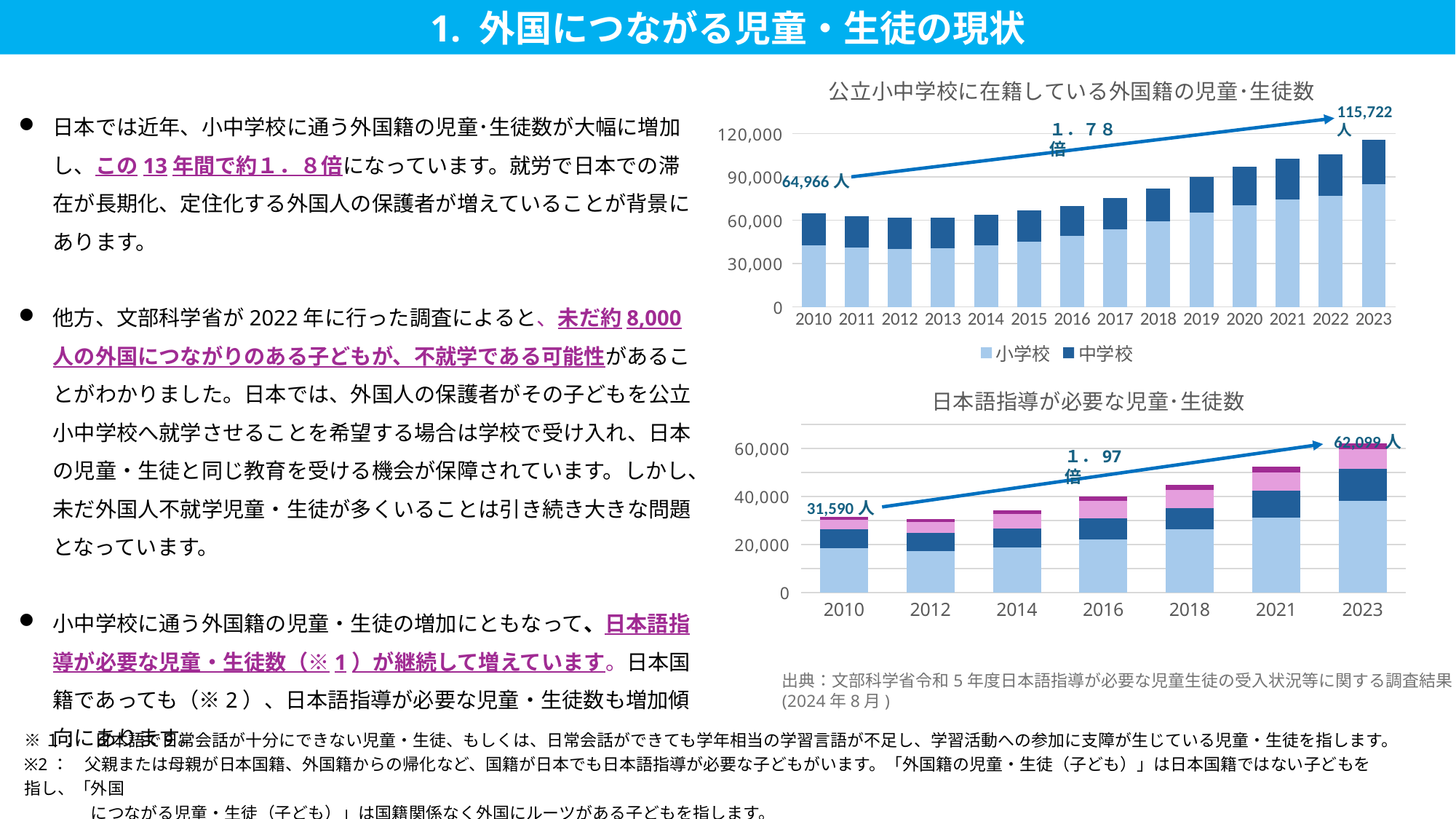
In the top chart (公立小中学校に在籍している外国籍の児童･生徒数), what is the difference between the 2023 total and the 2010 total? 50,756 人 What kind of chart is the top chart titled 公立小中学校に在籍している外国籍の児童･生徒数? bar chart In the bottom chart (日本語指導が必要な児童･生徒数), do the totals rise or fall from 2010 to 2023? rise In the top chart (公立小中学校に在籍している外国籍の児童･生徒数), what is the labelled total for 2023? 115,722 人 In the top chart (公立小中学校に在籍している外国籍の児童･生徒数), what is the labelled total for 2010? 64,966 人 In the top chart (公立小中学校に在籍している外国籍の児童･生徒数), how many years are shown on the x axis? 14 In the top chart (公立小中学校に在籍している外国籍の児童･生徒数), is the total for 2018 greater or less than 90,000? less What are the two legend entries of the top chart (公立小中学校に在籍している外国籍の児童･生徒数)? 小学校, 中学校 In the bottom chart (日本語指導が必要な児童･生徒数), what is the labelled total for 2010? 31,590 人 How many series does the legend of the top chart (公立小中学校に在籍している外国籍の児童･生徒数) list? 2 In the top chart (公立小中学校に在籍している外国籍の児童･生徒数), which year has the highest total? 2023 In the bottom chart (日本語指導が必要な児童･生徒数), how many years are shown on the x axis? 7